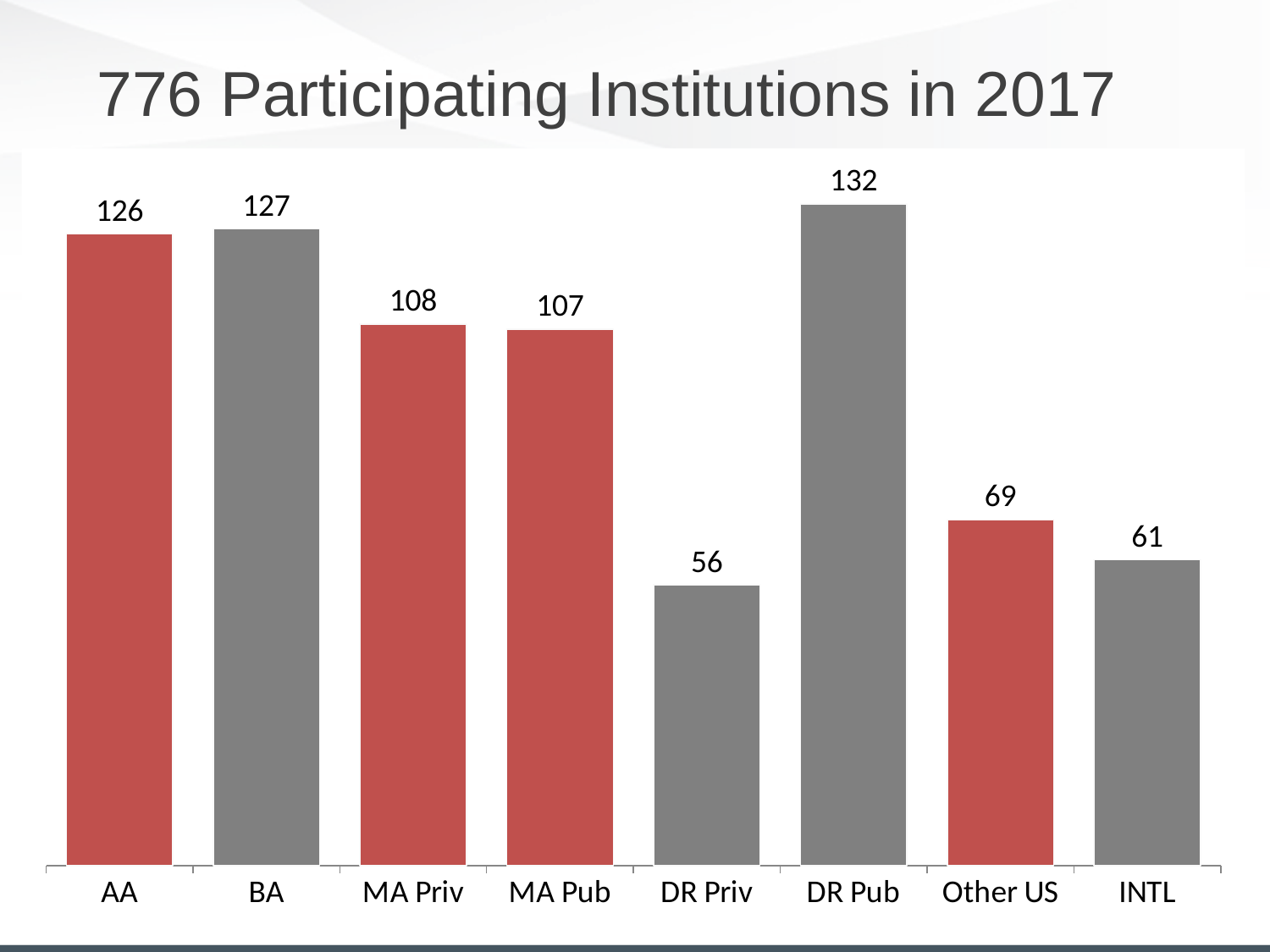
What is the difference between the values for DR Pub and DR Priv? 76 What is the difference between the values for Other US and INTL? 8 Which category has the lowest value? DR Priv What colour is the bar for DR Pub? Grey What is the title of the slide? 776 Participating Institutions in 2017 What is the value for DR Pub? 132 Which category has the highest value? DR Pub Which is larger, the value for AA or the value for Other US? AA What kind of chart is shown on the slide? Bar chart What is the value for INTL? 61 What is the value for MA Priv? 108 How many categories are shown on the x axis? 8